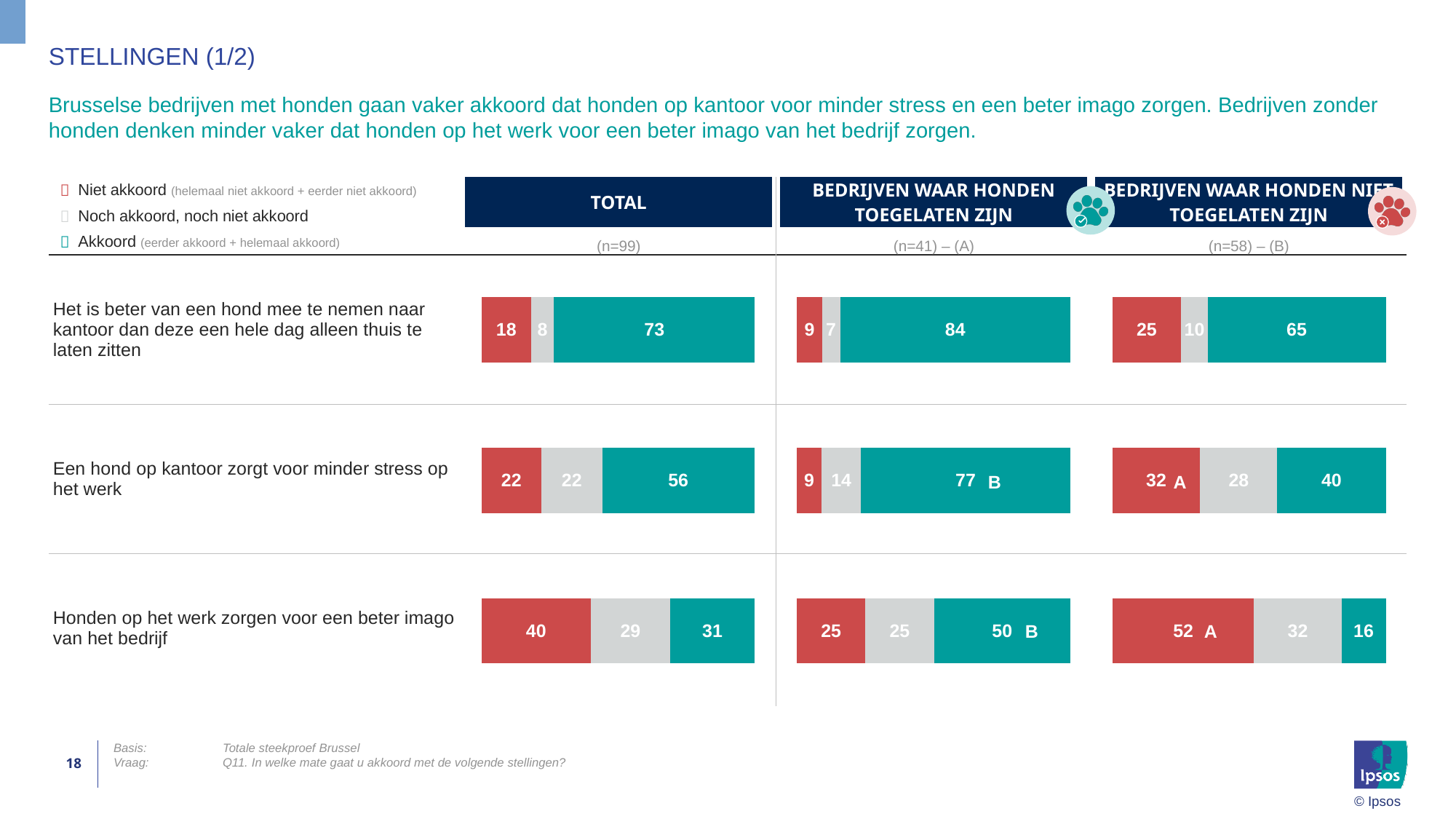
In the TOTAL chart, what is the 'Noch akkoord, noch niet akkoord' value for 'Een hond op kantoor zorgt voor minder stress op het werk'? 22 How many statements are shown in each chart? 3 In the 'BEDRIJVEN WAAR HONDEN TOEGELATEN ZIJN' chart, what is the 'Niet akkoord' value for 'Een hond op kantoor zorgt voor minder stress op het werk'? 9 For 'Honden op het werk zorgen voor een beter imago van het bedrijf', is the 'Niet akkoord' value larger in the 'BEDRIJVEN WAAR HONDEN TOEGELATEN ZIJN' chart or in the 'BEDRIJVEN WAAR HONDEN NIET TOEGELATEN ZIJN' chart? BEDRIJVEN WAAR HONDEN NIET TOEGELATEN ZIJN In the 'BEDRIJVEN WAAR HONDEN TOEGELATEN ZIJN' chart, which statement has the lowest 'Akkoord' value? Honden op het werk zorgen voor een beter imago van het bedrijf What is the difference between the 'Akkoord' value for 'Een hond op kantoor zorgt voor minder stress op het werk' in the 'BEDRIJVEN WAAR HONDEN TOEGELATEN ZIJN' chart and in the 'BEDRIJVEN WAAR HONDEN NIET TOEGELATEN ZIJN' chart? 37 In the TOTAL chart, what is the 'Akkoord' value for the statement 'Het is beter van een hond mee te nemen naar kantoor dan deze een hele dag alleen thuis te laten zitten'? 73 What is the sample size (n) shown for the TOTAL chart? n=99 In the TOTAL chart, which statement has the highest 'Niet akkoord' value? Honden op het werk zorgen voor een beter imago van het bedrijf In the 'BEDRIJVEN WAAR HONDEN NIET TOEGELATEN ZIJN' chart, what is the 'Akkoord' value for 'Honden op het werk zorgen voor een beter imago van het bedrijf'? 16 How many series does the legend list? 3 What kind of chart is used on this slide? Stacked bar chart